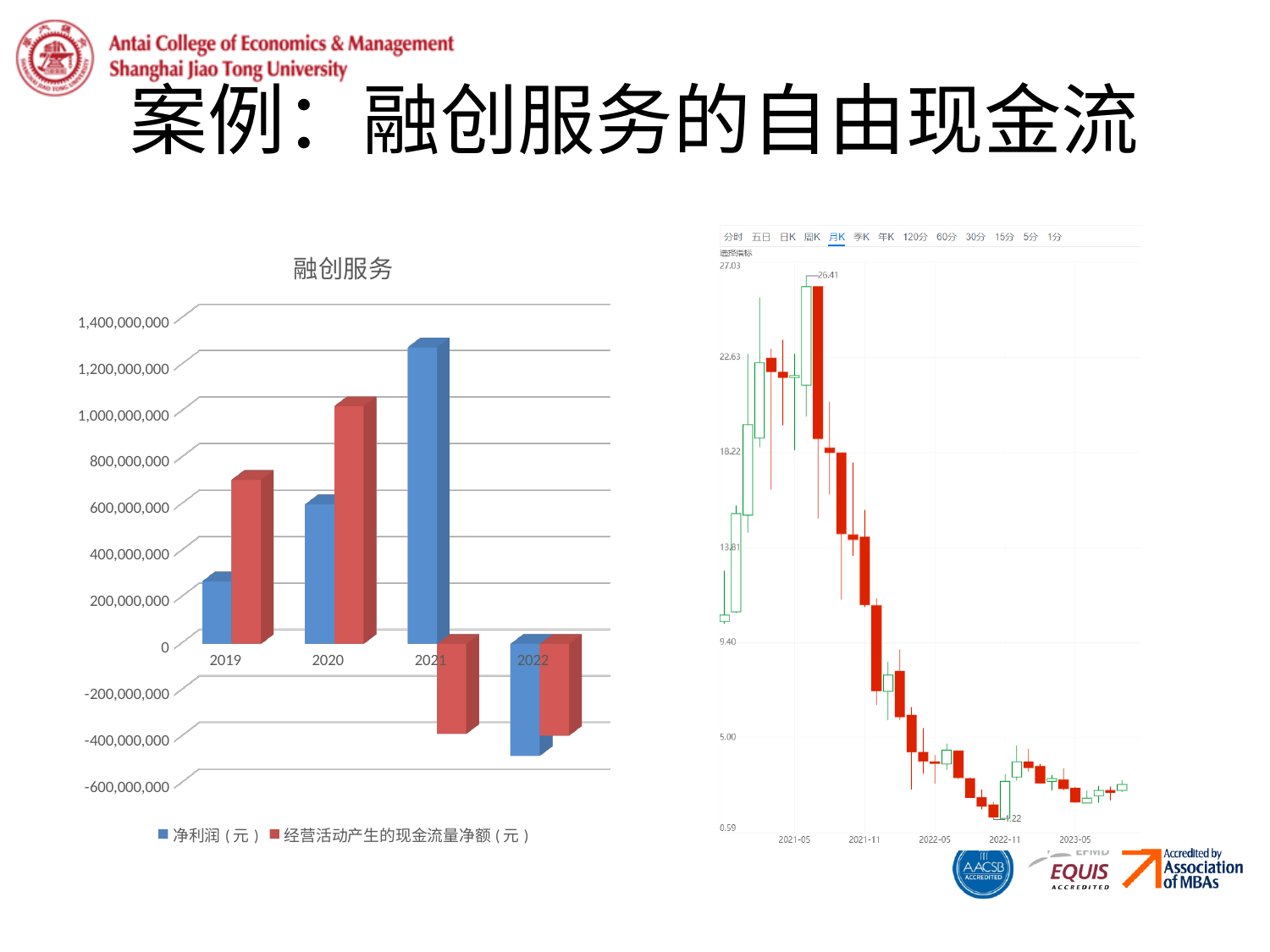
In the 融创服务 bar chart, which year has the highest 经营活动产生的现金流量净额(元)? 2020 In the 融创服务 bar chart, is the 净利润(元) for 2021 greater or less than 1,200,000,000? greater In the 融创服务 bar chart, which is larger for 2021: 净利润(元) or 经营活动产生的现金流量净额(元)? 净利润(元) In the 融创服务 bar chart, is the 经营活动产生的现金流量净额(元) for 2021 greater or less than -200,000,000? less What type of chart is the left chart titled 融创服务? bar chart In the stock price chart on the right, does the price generally rise or fall from 2021-05 to 2023-05? fall In the 融创服务 bar chart, which year has the lowest 净利润(元)? 2022 How many series does the legend of the 融创服务 bar chart list? 2 In the 融创服务 bar chart, is the 净利润(元) for 2019 greater or less than 400,000,000? less In the 融创服务 bar chart, which is larger for 2019: 净利润(元) or 经营活动产生的现金流量净额(元)? 经营活动产生的现金流量净额(元) In the 融创服务 bar chart, which year has the highest 净利润(元)? 2021 How many years are shown on the x axis of the 融创服务 bar chart? 4